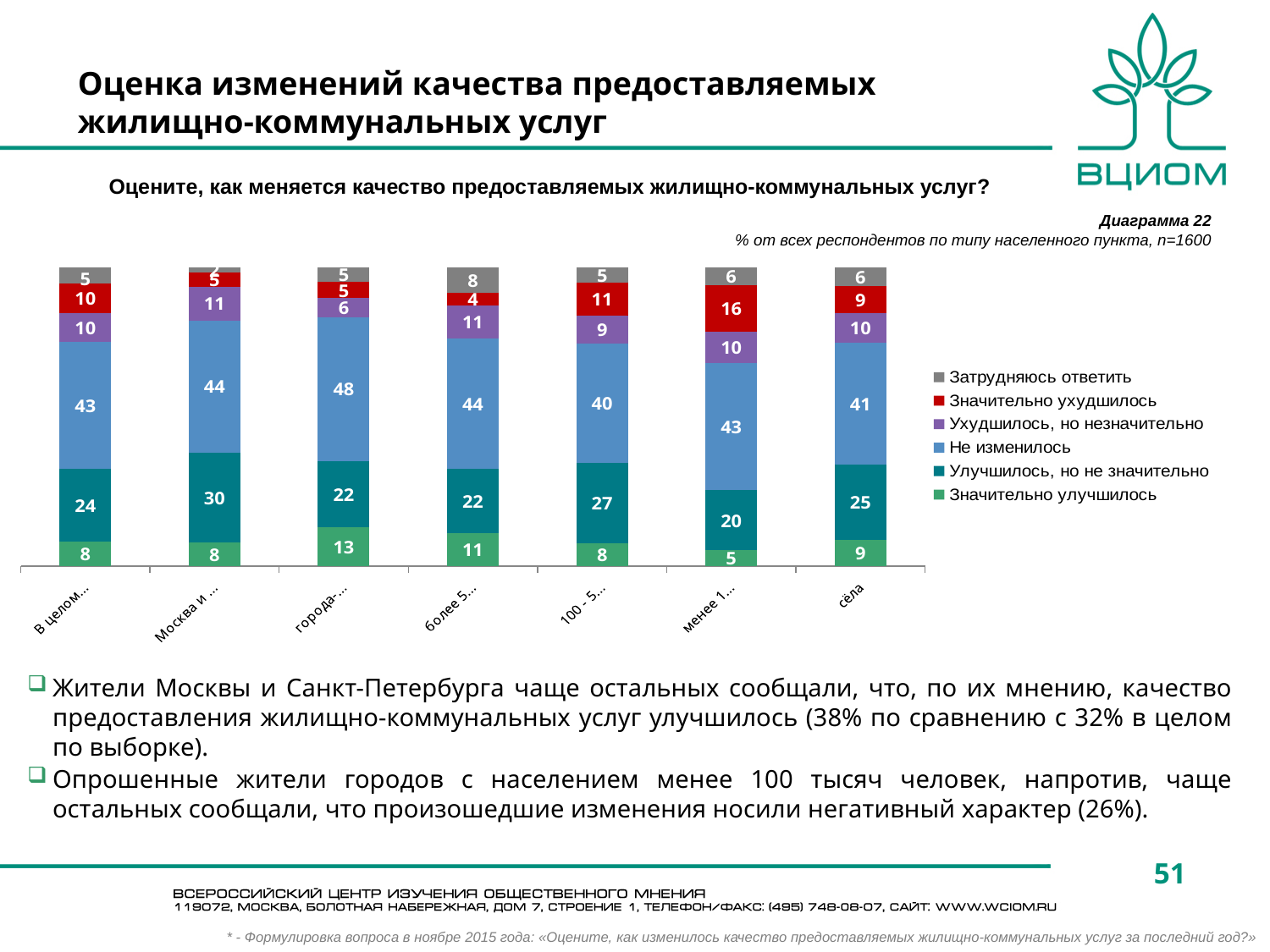
What is the value of the 'Не изменилось' segment for the 'сёла' category? 41 What colour represents the 'Не изменилось' series in the legend? blue What is the total of all segments in the 'сёла' bar? 100 What is the value of the 'Значительно ухудшилось' segment for the leftmost bar ('В целом…')? 10 For the 'сёла' category, which is larger: the 'Улучшилось, но не значительно' segment or the 'Ухудшилось, но незначительно' segment? Улучшилось, но не значительно How many series does the chart legend list? 6 What is the value of the 'Значительно улучшилось' segment for the 'сёла' category? 9 What is the value of the 'Не изменилось' segment for the leftmost bar ('В целом…')? 43 How many categories (bars) are plotted on the chart? 7 For the 'сёла' category, what is the difference between the 'Не изменилось' segment and the 'Улучшилось, но не значительно' segment? 16 Which bar has the largest 'Значительно улучшилось' segment? the third bar from the left (города…) What type of chart is shown on the slide? stacked bar chart